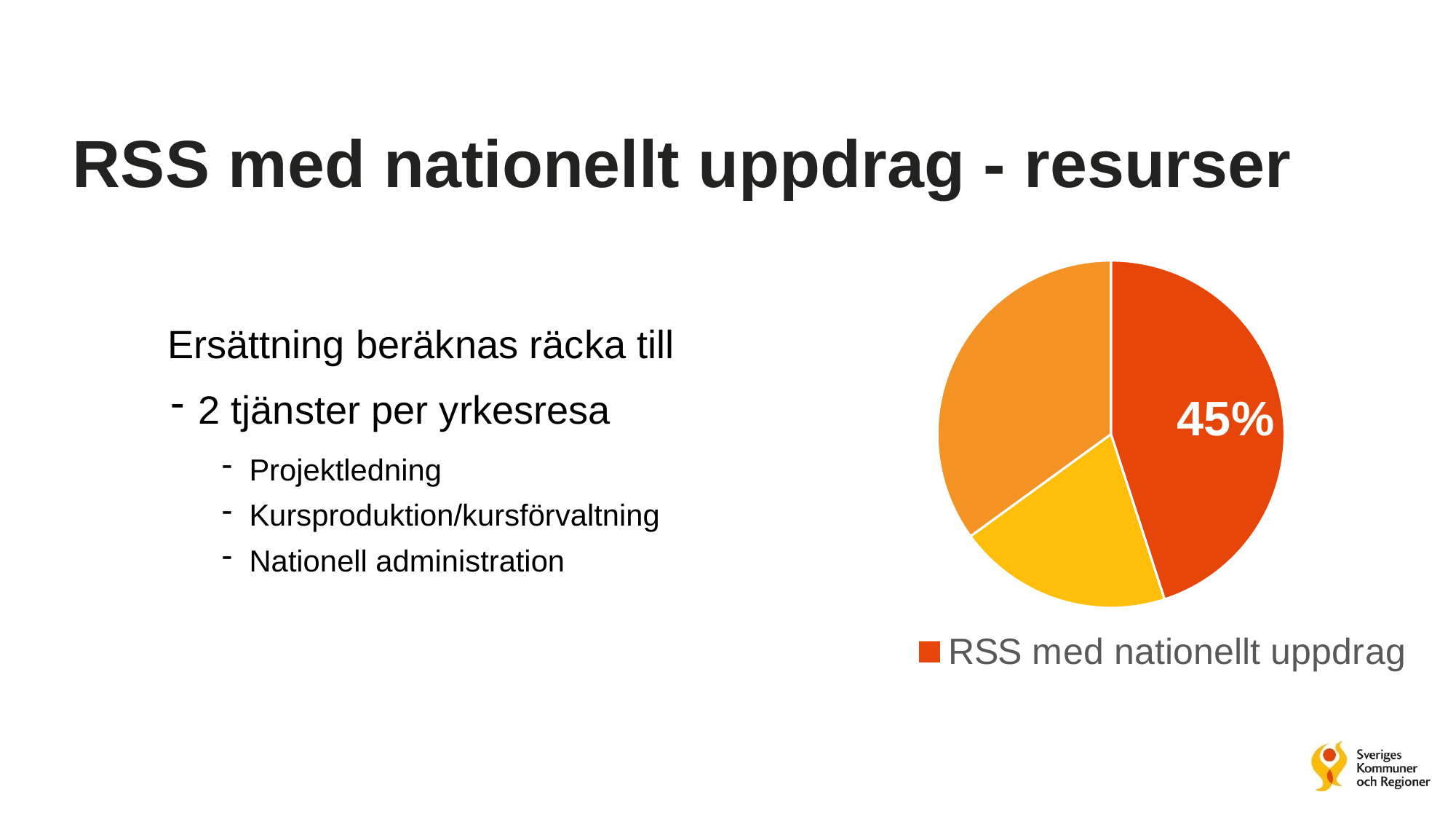
What is the only entry listed in the pie chart's legend? RSS med nationellt uppdrag What share of the pie does the RSS med nationellt uppdrag slice represent? 45% How many entries does the legend of the pie chart list? 1 Is the slice labelled 45% larger or smaller than the yellow slice? larger How many slices does the pie chart have? 3 What percentage is shown for the slice labelled RSS med nationellt uppdrag? 45% Is the value for RSS med nationellt uppdrag greater or less than 50%? less What kind of chart is shown on the slide? Pie chart What colour is the slice labelled 45% in the pie chart? Red-orange Which slice of the pie chart is the largest? RSS med nationellt uppdrag